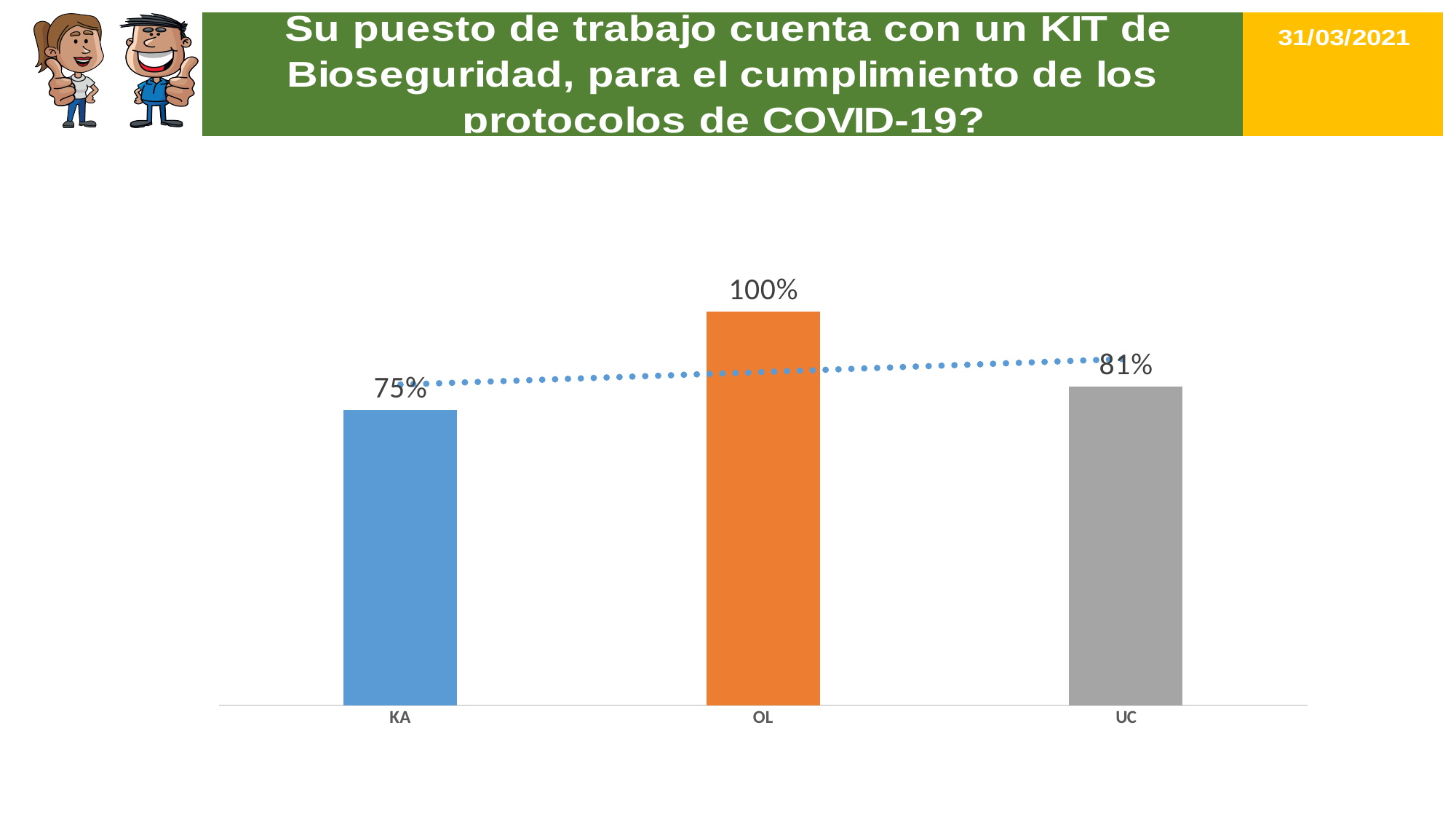
What colour is the bar for OL? Orange Which category has the highest value? OL What is the value for UC? 81% What kind of chart is shown on the slide? Bar chart Which category has the lowest value? KA Which is larger, the value for UC or the value for KA? UC What is the value for KA? 75% What is the value for OL? 100% How many categories are shown on the x axis? 3 What is the difference between the values for UC and KA? 6% What is the difference between the values for OL and KA? 25% What date is shown in the top right corner of the slide? 31/03/2021